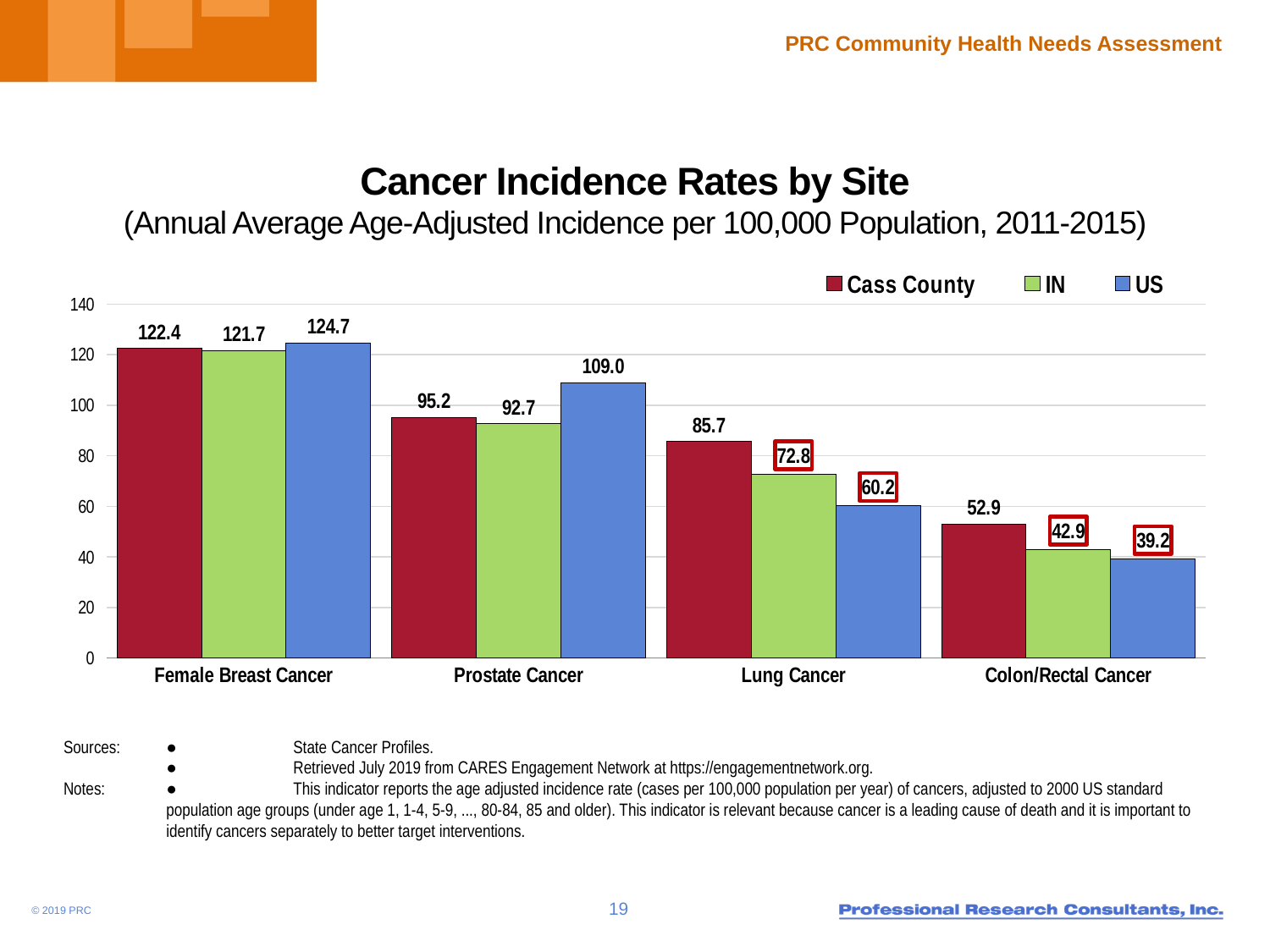
What is the Cass County cancer incidence rate for Lung Cancer? 85.7 How many series does the legend list? 3 Which series is shown in blue in the legend? US Which cancer site has the lowest US incidence rate? Colon/Rectal Cancer What is the IN incidence rate for Colon/Rectal Cancer? 42.9 What is the difference between the US and IN incidence rates for Prostate Cancer? 16.3 What is the US incidence rate for Prostate Cancer? 109.0 What kind of chart is shown on the slide? Bar chart How many cancer sites are shown on the x axis? 4 Which cancer site has the highest Cass County incidence rate? Female Breast Cancer For Colon/Rectal Cancer, which is larger: the Cass County rate or the IN rate? Cass County What is the difference between the Cass County and US incidence rates for Lung Cancer? 25.5